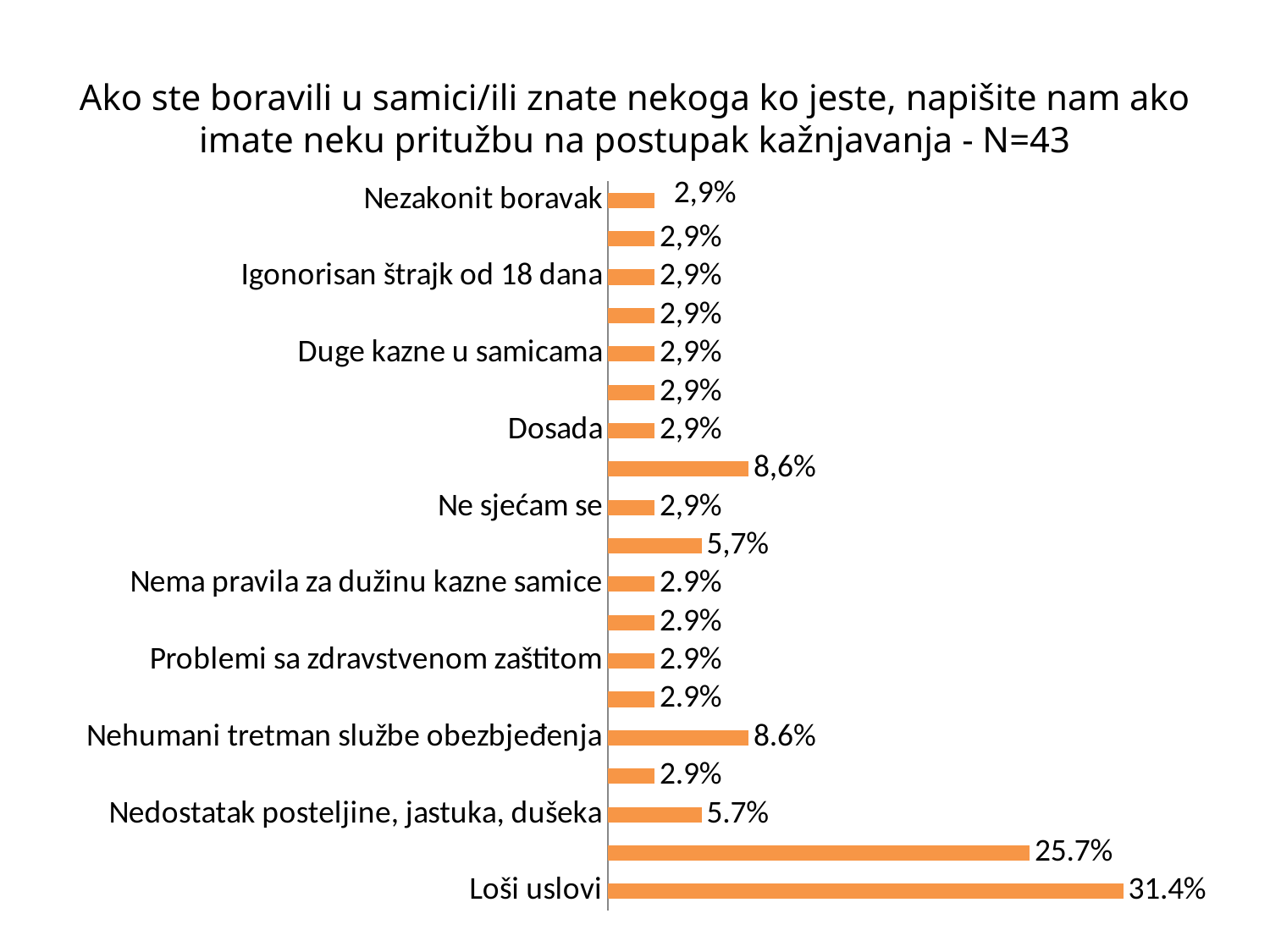
What is the value for "Nedostatak posteljine, jastuka, dušeka"? 5.7% What is the value for "Nezakonit boravak"? 2,9% Which is larger: the value for "Nehumani tretman službe obezbjeđenja" or for "Nedostatak posteljine, jastuka, dušeka"? Nehumani tretman službe obezbjeđenja What is the value for "Dosada"? 2,9% Which category has the highest value? Loši uslovi What is the difference between the values for "Nehumani tretman službe obezbjeđenja" and "Nedostatak posteljine, jastuka, dušeka"? 2.9 percentage points What kind of chart is shown on the slide? bar chart How many bars are plotted in the chart? 19 What is the value for "Loši uslovi"? 31.4% What is the value for "Nehumani tretman službe obezbjeđenja"? 8.6% What is the difference between the values for "Loši uslovi" and "Nehumani tretman službe obezbjeđenja"? 22.8 percentage points What sample size (N) is stated in the chart title? N=43